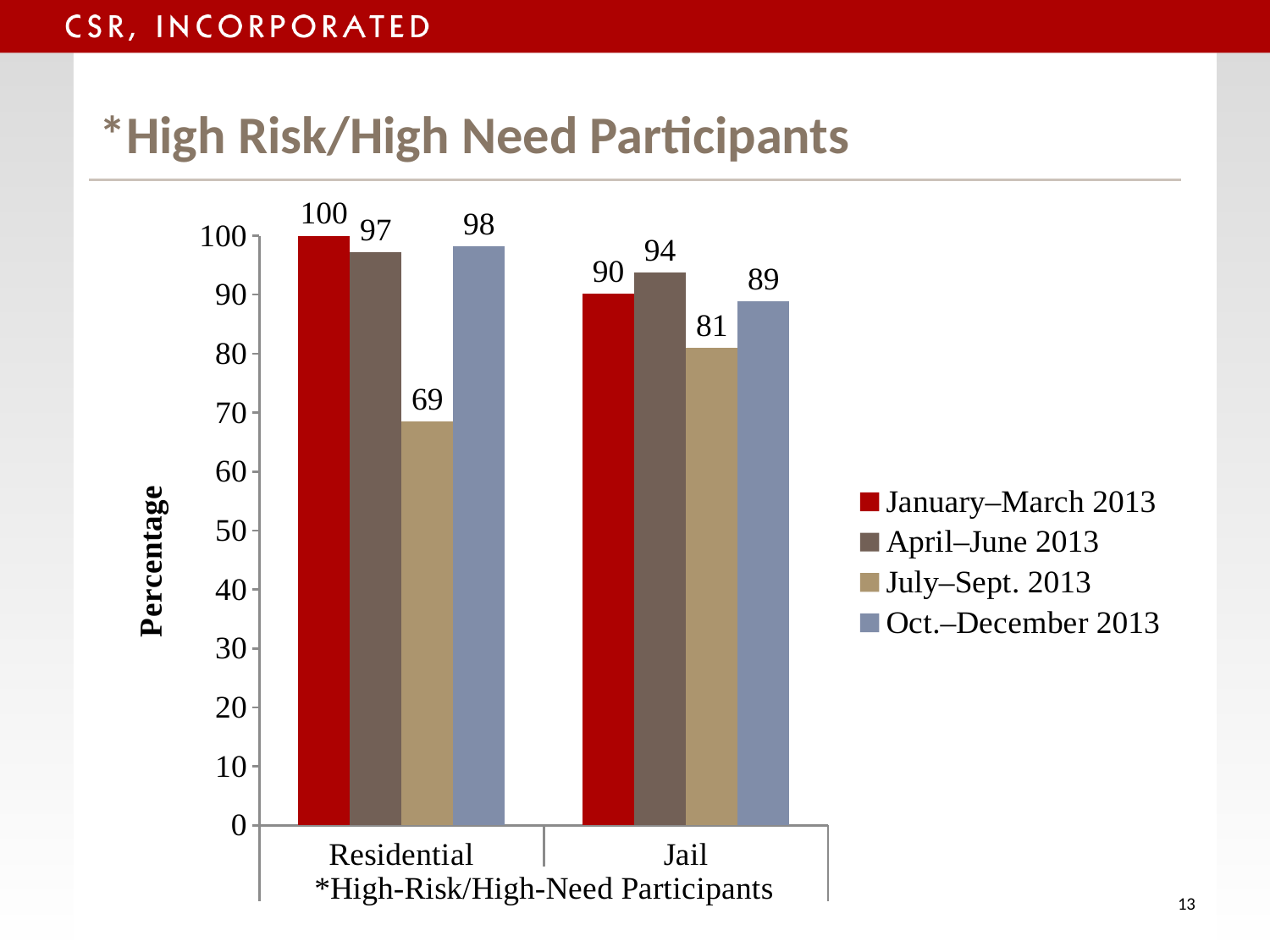
Which quarter has the highest value for Jail? April–June 2013 What is the value for Jail in July–Sept. 2013? 81 What is the label of the y axis? Percentage What is the value for Jail in Oct.–December 2013? 89 Which is larger, the Residential value for Oct.–December 2013 or the Jail value for Oct.–December 2013? Residential How many series does the legend list? 4 How many categories are shown on the x axis? 2 Which quarter has the lowest value for Residential? July–Sept. 2013 What is the difference between the Residential and Jail values for July–Sept. 2013? 12 What kind of chart is shown on the slide? Bar chart What is the value for Residential in January–March 2013? 100 What is the difference between the Residential and Jail values for April–June 2013? 3